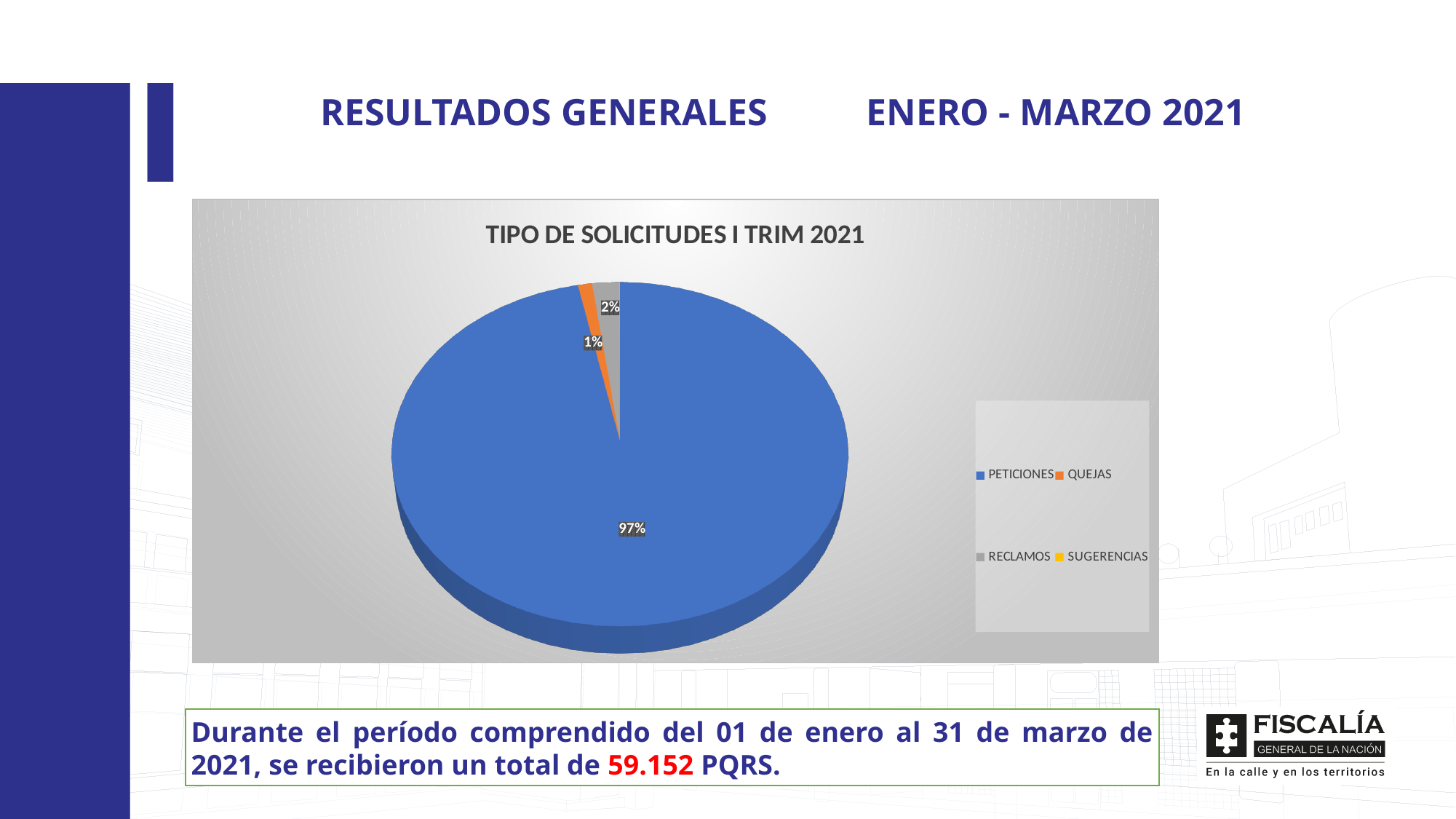
What is the difference in percentage points between the PETICIONES slice and the RECLAMOS slice? 95 Is the share for PETICIONES greater or less than 50%? greater What share of the pie does PETICIONES represent? 97% How many categories does the legend list? 4 Which category has the largest slice of the pie? PETICIONES What is the title of the chart? TIPO DE SOLICITUDES I TRIM 2021 What colour is the PETICIONES slice? blue What share of the pie does RECLAMOS represent? 2% Which is larger, the slice for RECLAMOS or the slice for QUEJAS? RECLAMOS What type of chart is shown on the slide? pie chart What share of the pie does QUEJAS represent? 1%